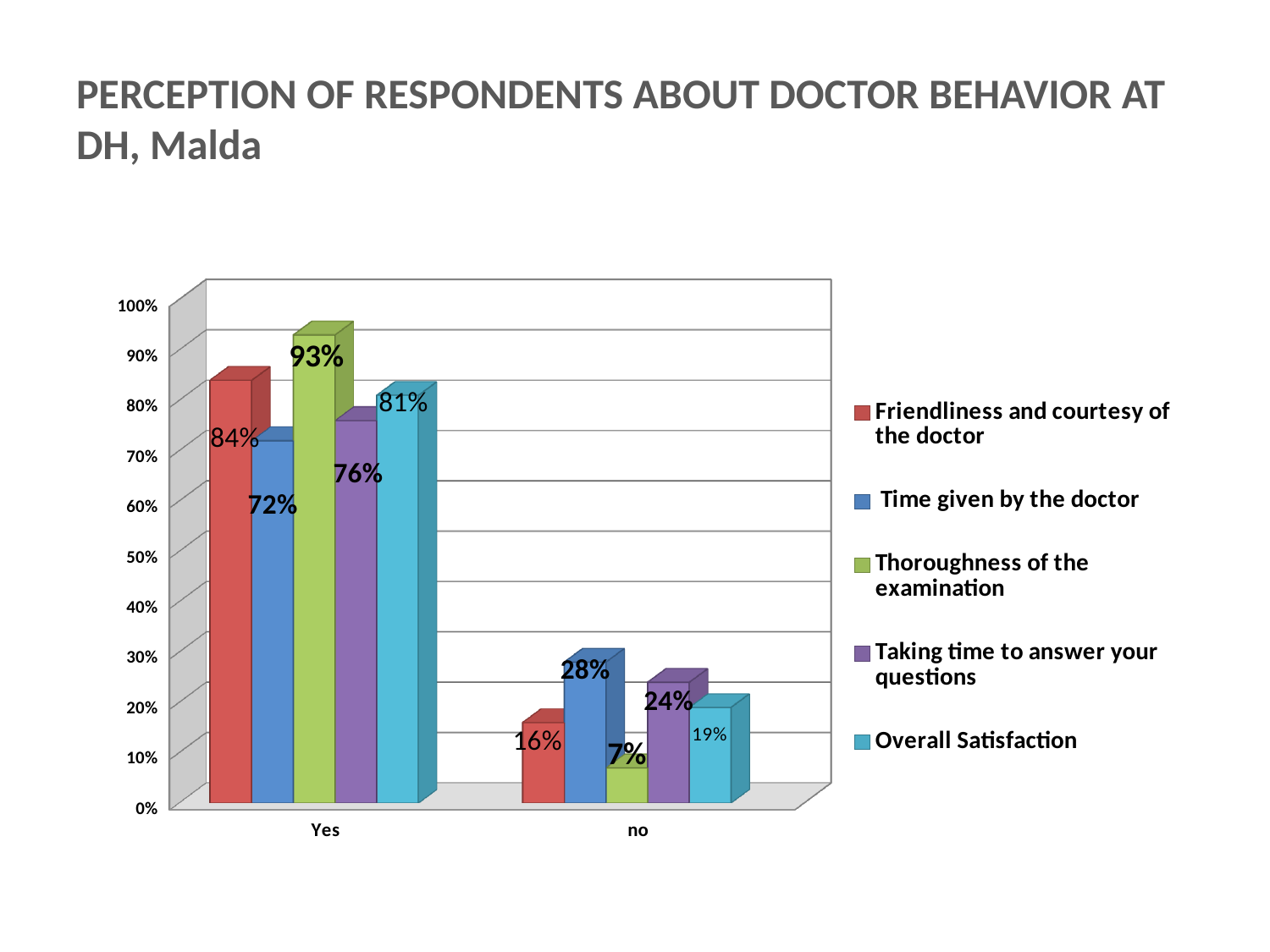
Is the value for Taking time to answer your questions in the no category greater or less than 20%? greater Which is larger: the Yes value for Taking time to answer your questions or the Yes value for Overall Satisfaction? Overall Satisfaction What is the value for Time given by the doctor in the no category? 28% Which series has the lowest value in the no category? Thoroughness of the examination What is the value for Friendliness and courtesy of the doctor in the no category? 16% What colour represents Overall Satisfaction in the legend? Light blue What is the value for Overall Satisfaction in the Yes category? 81% What is the difference between the Yes values for Friendliness and courtesy of the doctor and Time given by the doctor? 12% What is the value for Thoroughness of the examination in the Yes category? 93% Which series has the highest value in the Yes category? Thoroughness of the examination How many series does the legend list? 5 What kind of chart is shown on the slide? Bar chart